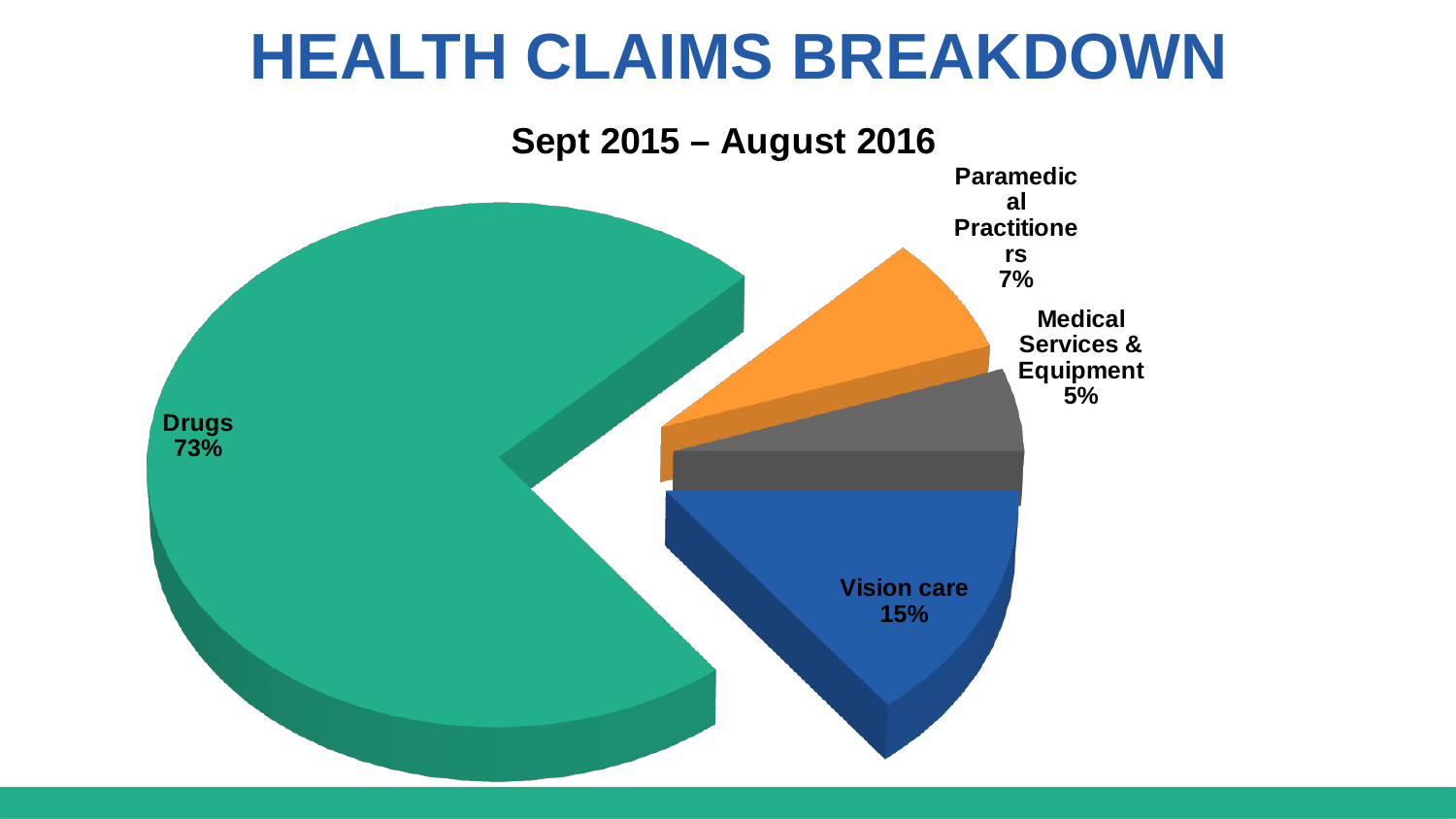
What is the difference in percentage points between Paramedical Practitioners and Medical Services & Equipment? 2 What share of health claims is for Medical Services & Equipment? 5% What time period does the chart cover? Sept 2015 – August 2016 Which category has the smallest share of health claims? Medical Services & Equipment Which category has the largest share of health claims? Drugs What share of health claims is for Paramedical Practitioners? 7% What share of health claims is for Vision care? 15% What share of health claims is for Drugs? 73% How many categories are shown in the pie chart? 4 Which is larger, the share for Vision care or the share for Paramedical Practitioners? Vision care What kind of chart is shown on the slide? Pie chart How many percentage points larger is the Drugs share than the Vision care share? 58